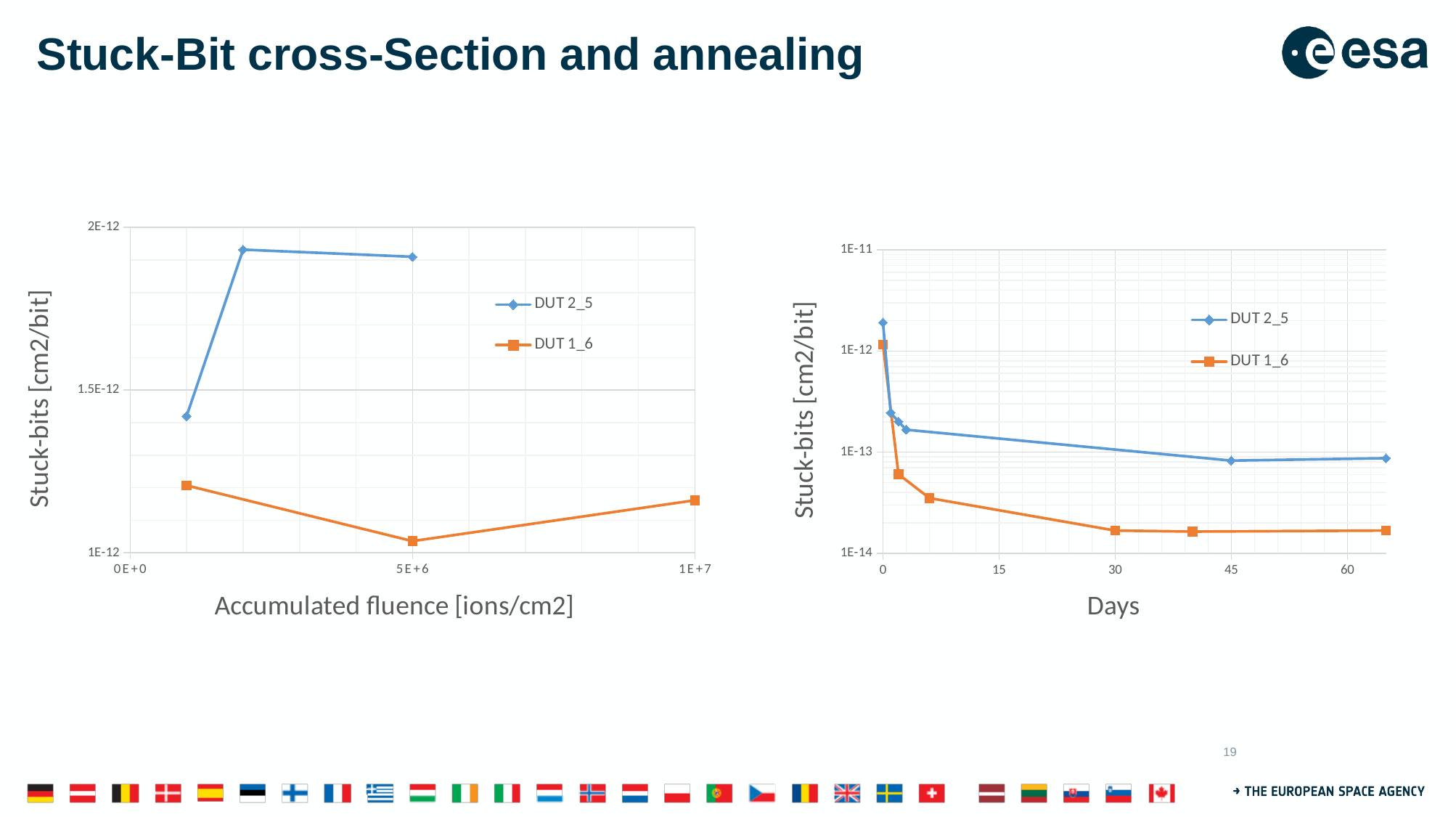
What kind of chart is the left chart (Accumulated fluence on the x axis)? line chart What is the x-axis title of the right chart? Days What kind of chart is the right chart (Days on the x axis)? line chart In the left chart, is the highest value for DUT 2_5 greater or less than 1.5E-12? greater In the right chart, do the stuck-bit values for DUT 1_6 rise or fall as the number of days increases? fall In the right chart, which series are listed in the legend? DUT 2_5 and DUT 1_6 In the right chart, is the value for DUT 1_6 at 30 days greater or less than 1E-13? less In the left chart, is the value for DUT 1_6 at 5E+6 ions/cm2 greater or less than 1.5E-12? less How many series does the legend of the left chart list? 2 In the left chart, which series has the higher values overall, DUT 2_5 or DUT 1_6? DUT 2_5 In the left chart, how many data points are plotted for DUT 2_5? 3